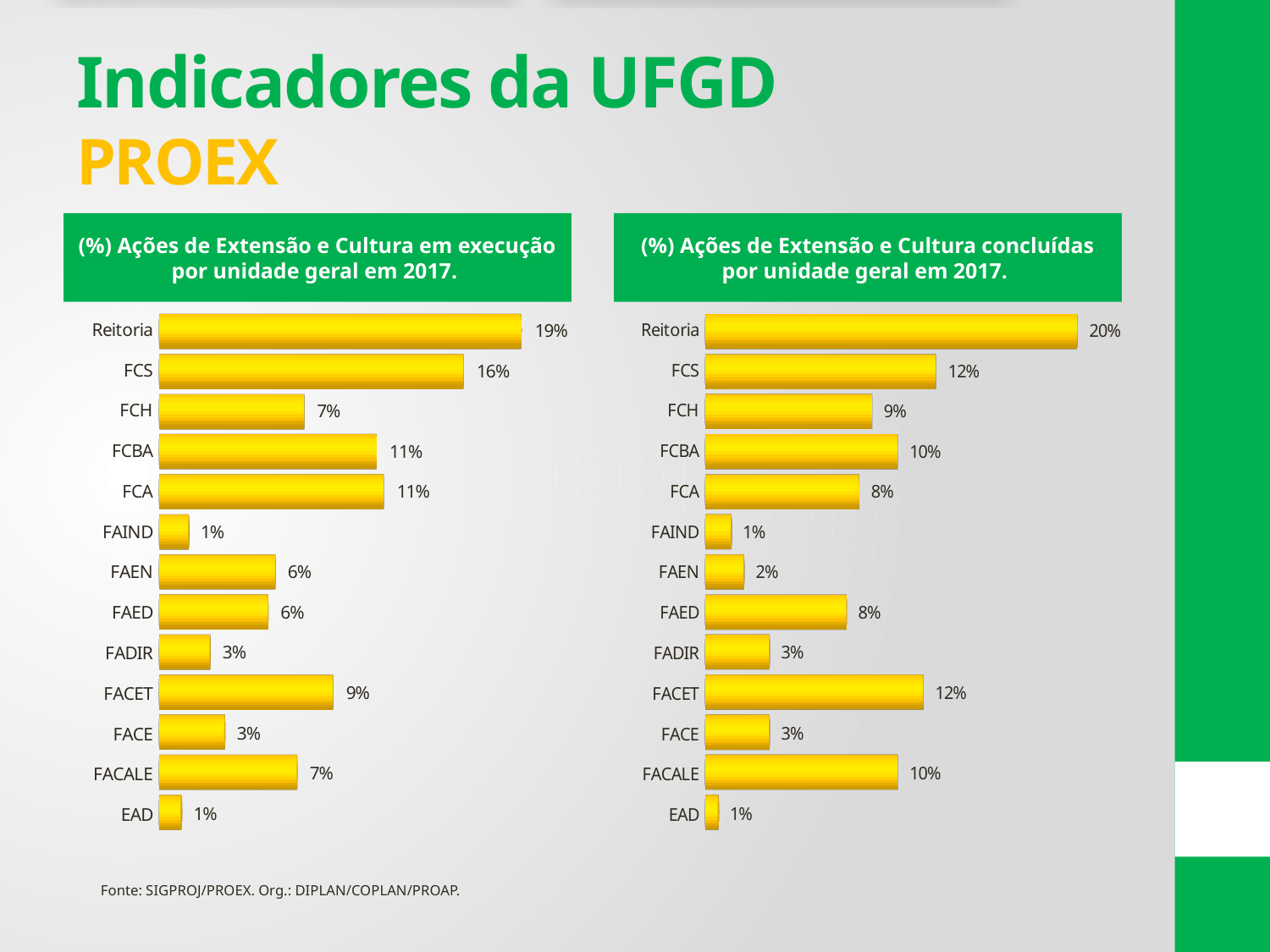
In the left chart (em execução), which unit has the highest value? Reitoria In the right chart (concluídas), which is larger, FAED or FAEN? FAED In the right chart (concluídas), what is the value for FACET? 12% In the left chart (em execução), what is the difference between Reitoria and FCS? 3% In the left chart (em execução), what is the value for FCBA? 11% What type of chart is the right chart (concluídas)? Bar chart In the left chart (em execução), which is larger, FACET or FACALE? FACET How many units are shown in the left chart (em execução)? 13 In the left chart (em execução), what is the value for FCS? 16% In the right chart (concluídas), which unit has the highest value? Reitoria In the right chart (concluídas), what is the difference between FCS and FCH? 3% What is the title of the right chart? (%) Ações de Extensão e Cultura concluídas por unidade geral em 2017.